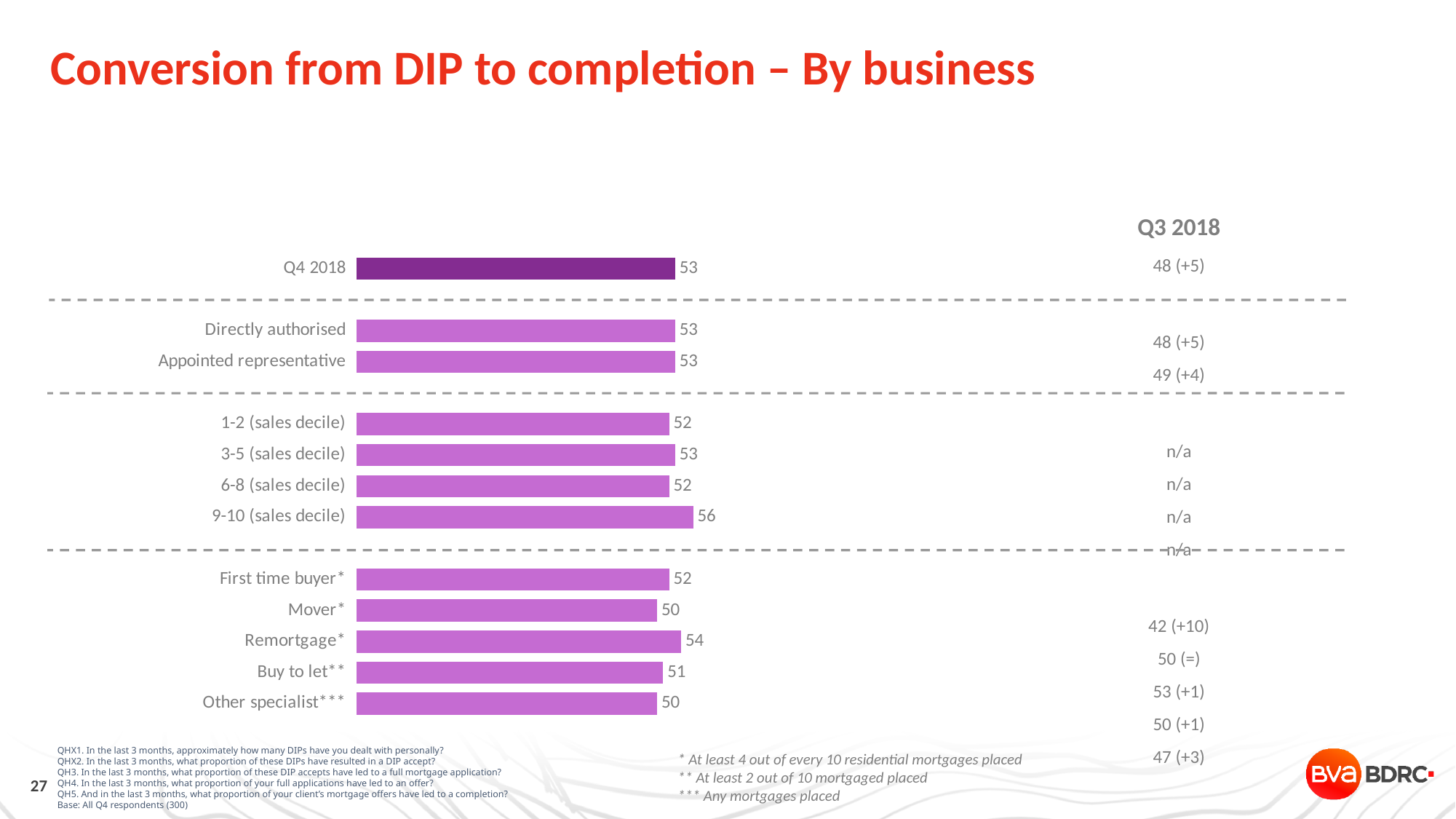
What kind of chart is shown on the slide? Bar chart What is the value for 9-10 (sales decile)? 56 Which category has the highest value? 9-10 (sales decile) What is the value for Buy to let? 51 What is the difference between the values for 9-10 (sales decile) and 1-2 (sales decile)? 4 Which is larger, the value for Remortgage or the value for Buy to let? Remortgage What is the difference between the values for Remortgage and Other specialist? 4 What is the value for Q4 2018? 53 What is the value for Mover? 50 What is the value for Remortgage? 54 Which is larger, the value for 9-10 (sales decile) or the value for First time buyer? 9-10 (sales decile) How many bars are plotted in the chart? 12